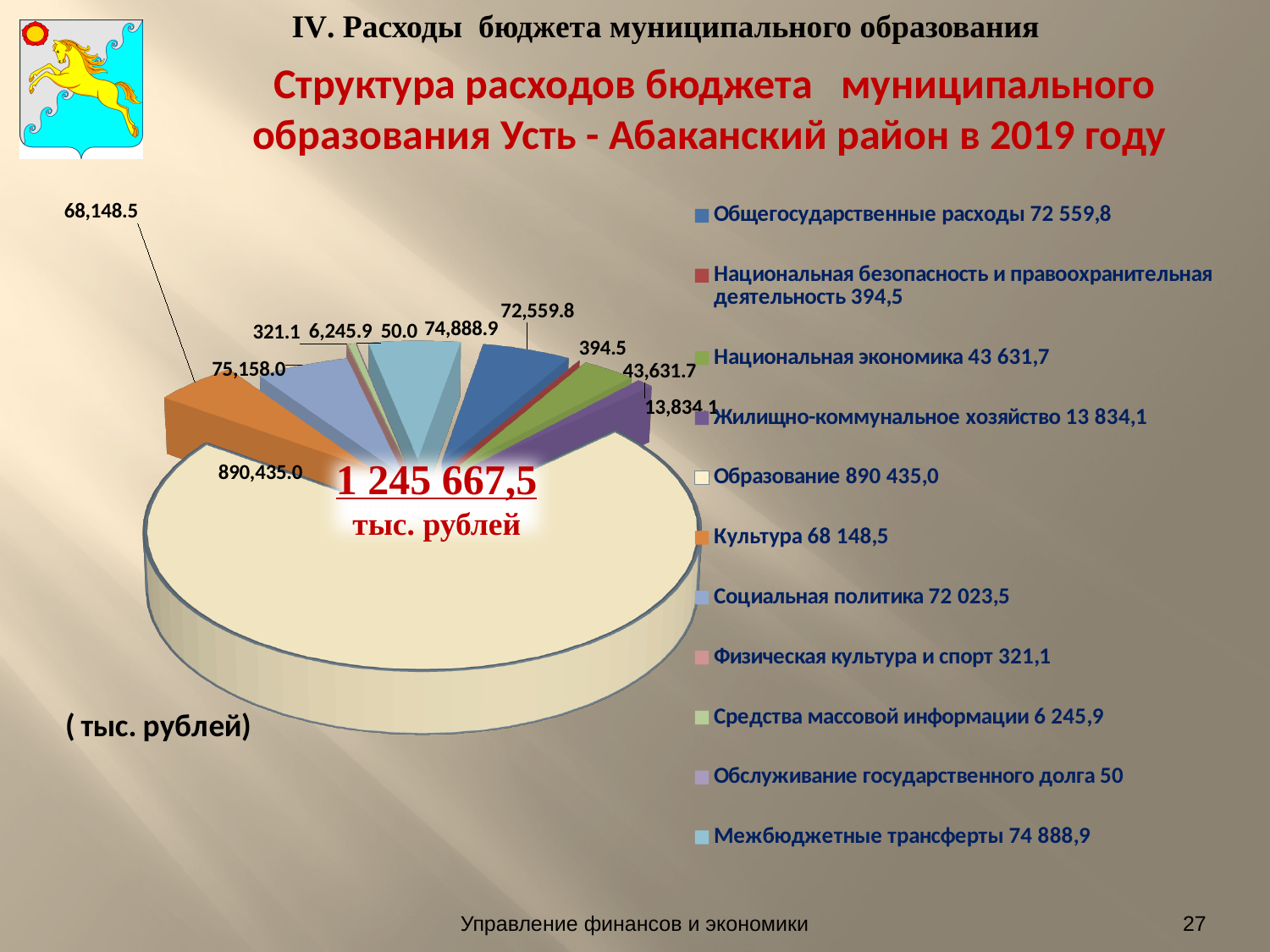
What kind of chart is shown on the slide? pie chart Which category has the largest slice of the pie? Образование Which category has the smallest value? Обслуживание государственного долга What is the value for Общегосударственные расходы? 72 559,8 Which is larger, Национальная экономика or Жилищно-коммунальное хозяйство? Национальная экономика What is the value for Национальная экономика? 43 631,7 How many categories does the legend list? 11 What is the difference between Культура (68 148,5) and Средства массовой информации (6 245,9)? 61 902,6 What year does the chart title say the budget expenditure structure refers to? 2019 What total is printed in the centre of the pie chart? 1 245 667,5 тыс. рублей What is the value for Жилищно-коммунальное хозяйство? 13 834,1 What is the value for Межбюджетные трансферты? 74 888,9